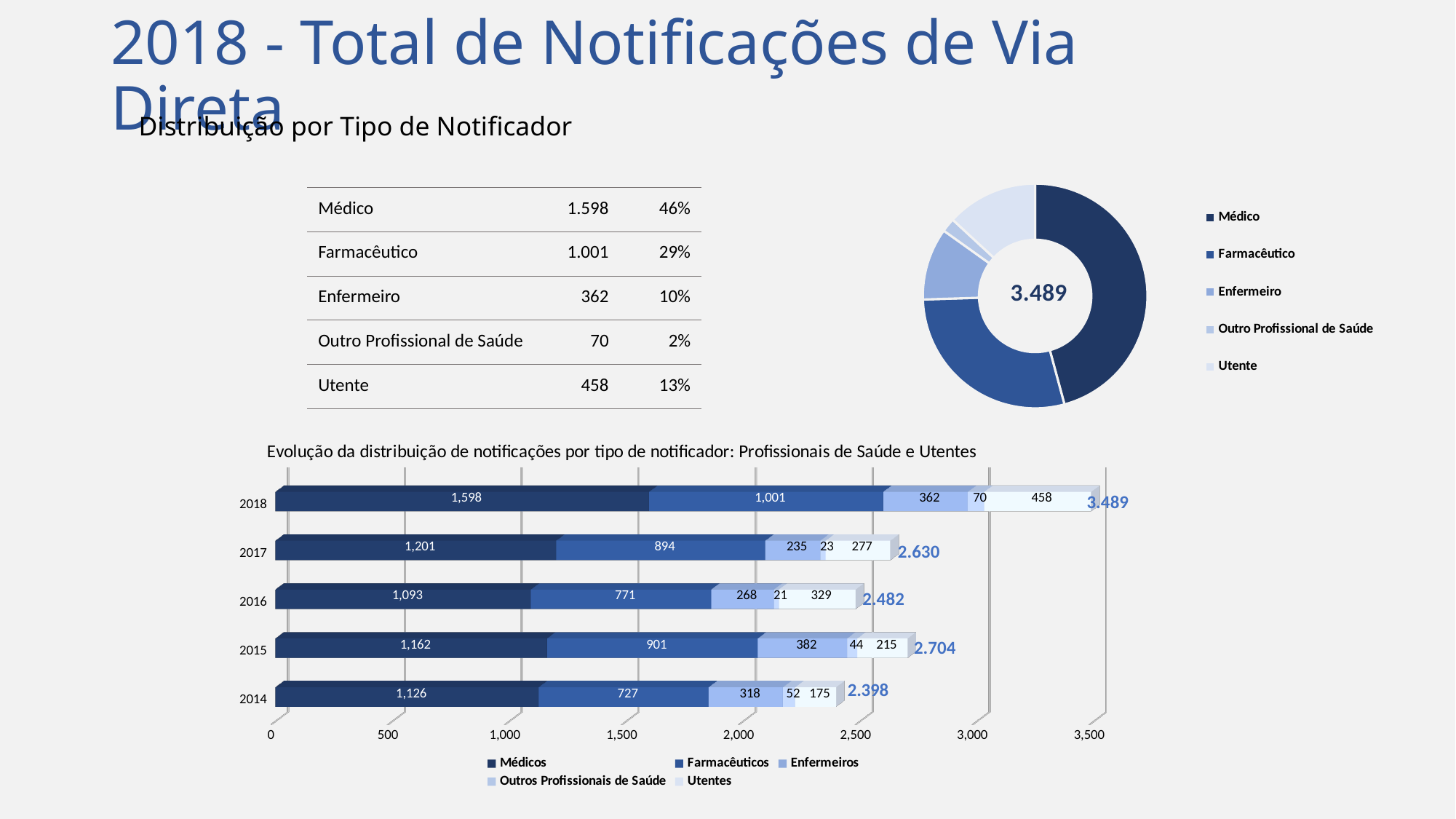
In the bar chart 'Evolução da distribuição de notificações por tipo de notificador', how many series does the legend list? 5 In the bar chart 'Evolução da distribuição de notificações por tipo de notificador', what is the value for Outros Profissionais de Saúde in 2016? 21 What type of chart is the chart at the bottom of the slide? Stacked bar chart In the bar chart 'Evolução da distribuição de notificações por tipo de notificador', which year has the highest total? 2018 In the bar chart 'Evolução da distribuição de notificações por tipo de notificador', which year has the lowest total? 2014 In the bar chart 'Evolução da distribuição de notificações por tipo de notificador', what is the total of the stacked bar for 2017? 2.630 In the doughnut chart at the top right of the slide, what total is printed in the centre? 3.489 In the bar chart 'Evolução da distribuição de notificações por tipo de notificador', which year has the larger Farmacêuticos value, 2015 or 2016? 2015 In the bar chart 'Evolução da distribuição de notificações por tipo de notificador', what is the difference between the Médicos value in 2018 and in 2017? 397 In the bar chart 'Evolução da distribuição de notificações por tipo de notificador', how many years are shown? 5 In the bar chart 'Evolução da distribuição de notificações por tipo de notificador', what is the value for Utentes in 2015? 215 In the bar chart 'Evolução da distribuição de notificações por tipo de notificador', what is the value for Médicos in 2018? 1,598